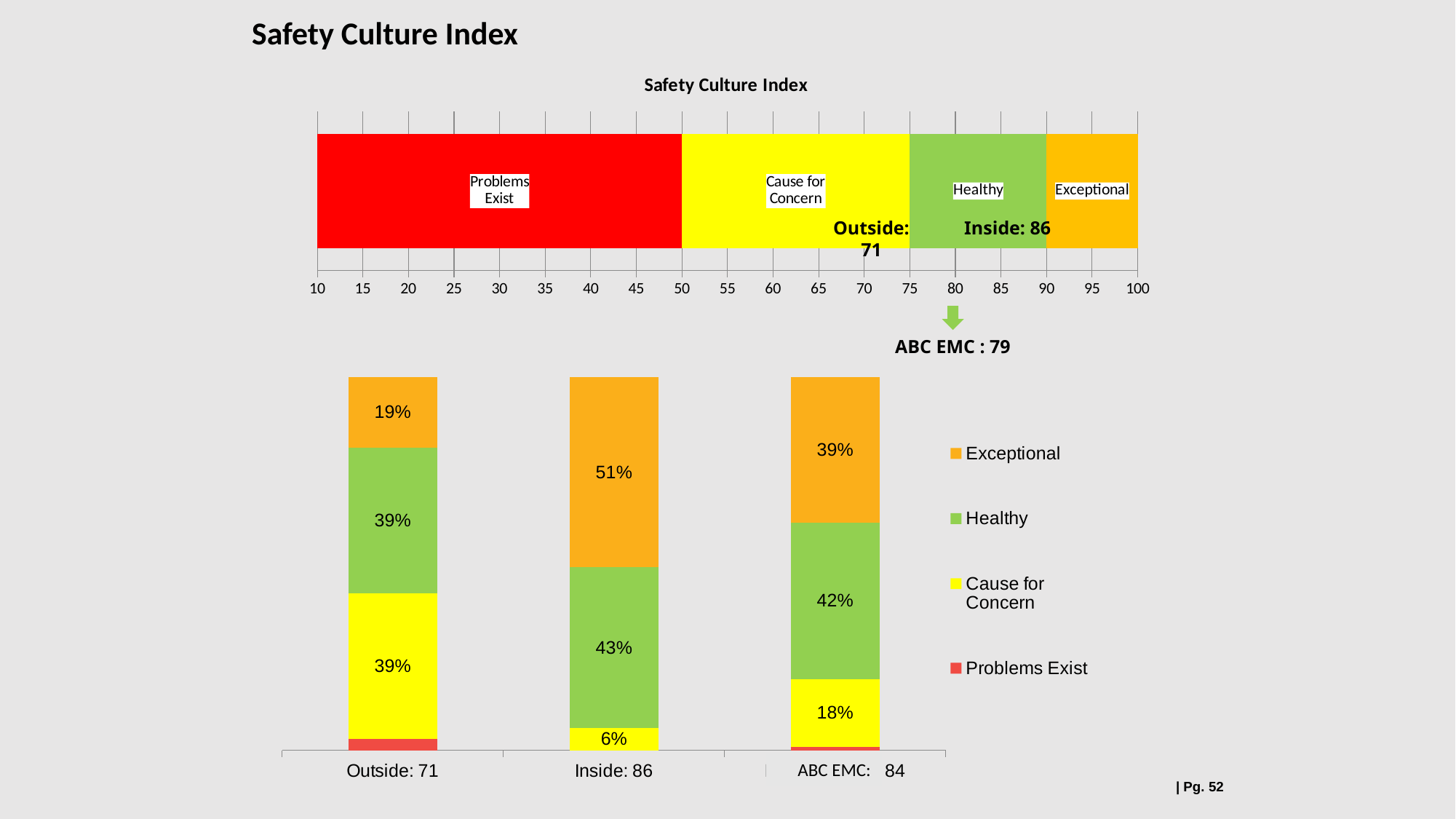
In the bottom stacked bar chart, what is the Cause for Concern share for Outside: 71? 39% What kind of chart is the bottom chart on the slide? Stacked bar chart In the bottom stacked bar chart, how much larger is the Exceptional share for Inside: 86 than for Outside: 71? 32 percentage points In the bottom stacked bar chart, what is the Exceptional share for Inside: 86? 51% In the bottom stacked bar chart, what is the Healthy share for ABC EMC: 84? 42% In the bottom stacked bar chart, which bar has the lowest Cause for Concern share? Inside: 86 In the top Safety Culture Index chart, what score is shown for Inside? 86 In the bottom stacked bar chart, which bar has the highest Exceptional share? Inside: 86 In the top Safety Culture Index chart, which zone covers the range from 75 to 90? Healthy How many series does the legend of the bottom stacked bar chart list? 4 How many bars are shown in the bottom stacked bar chart? 3 In the bottom stacked bar chart, which has the larger Exceptional share, ABC EMC: 84 or Outside: 71? ABC EMC: 84